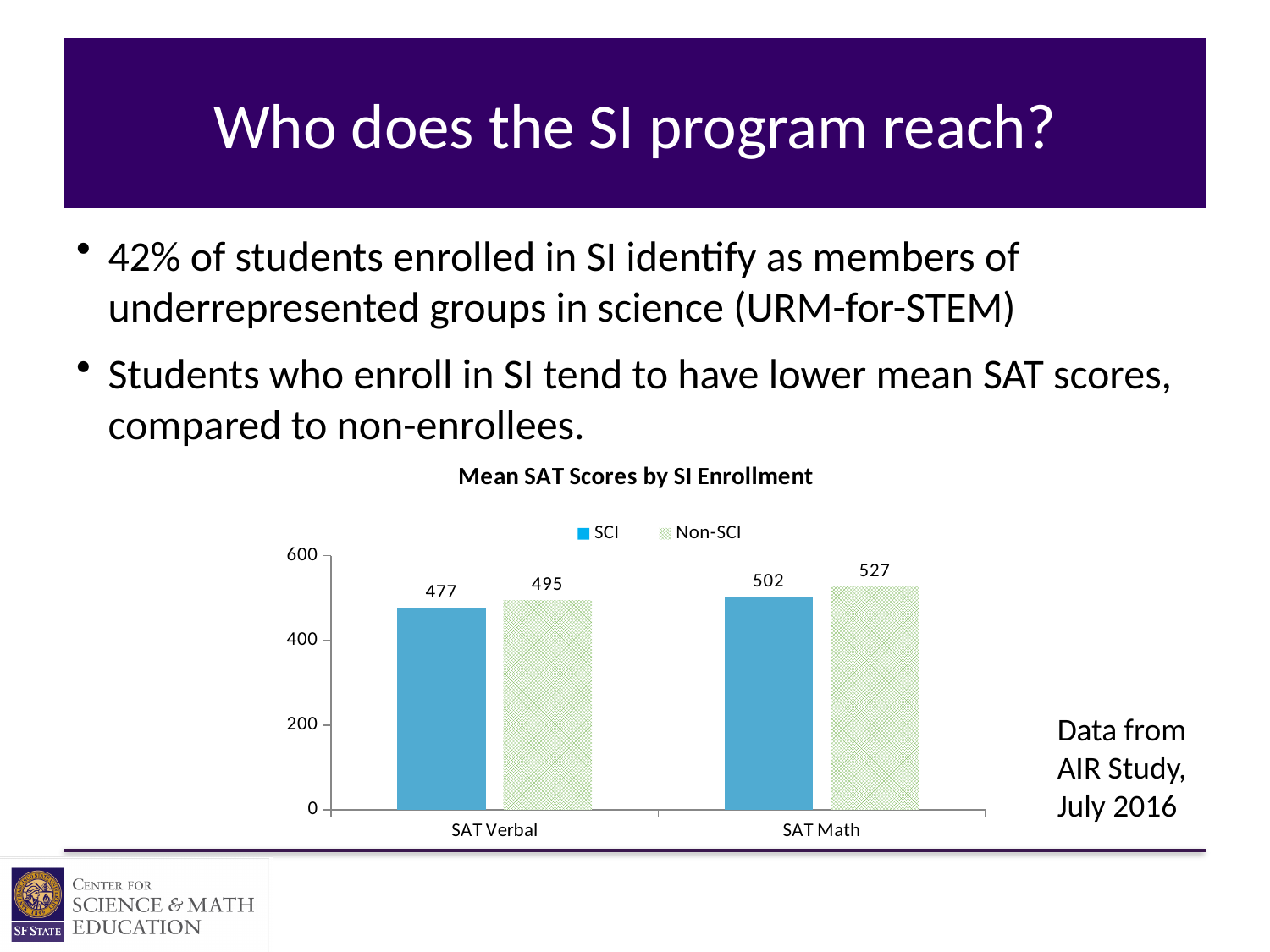
How many series does the legend list? 2 What is the mean SAT Verbal score for the Non-SCI series? 495 What is the title of the chart? Mean SAT Scores by SI Enrollment Which bar in the chart has the lowest value? SCI, SAT Verbal Which is larger, the SCI SAT Math score or the Non-SCI SAT Verbal score? SCI SAT Math What kind of chart is shown on the slide? Bar chart What is the difference between the Non-SCI and SCI mean SAT Verbal scores? 18 What is the difference between the Non-SCI and SCI mean SAT Math scores? 25 What is the mean SAT Math score for the Non-SCI series? 527 What is the mean SAT Verbal score for the SCI series? 477 Which bar in the chart has the highest value? Non-SCI, SAT Math What is the mean SAT Math score for the SCI series? 502